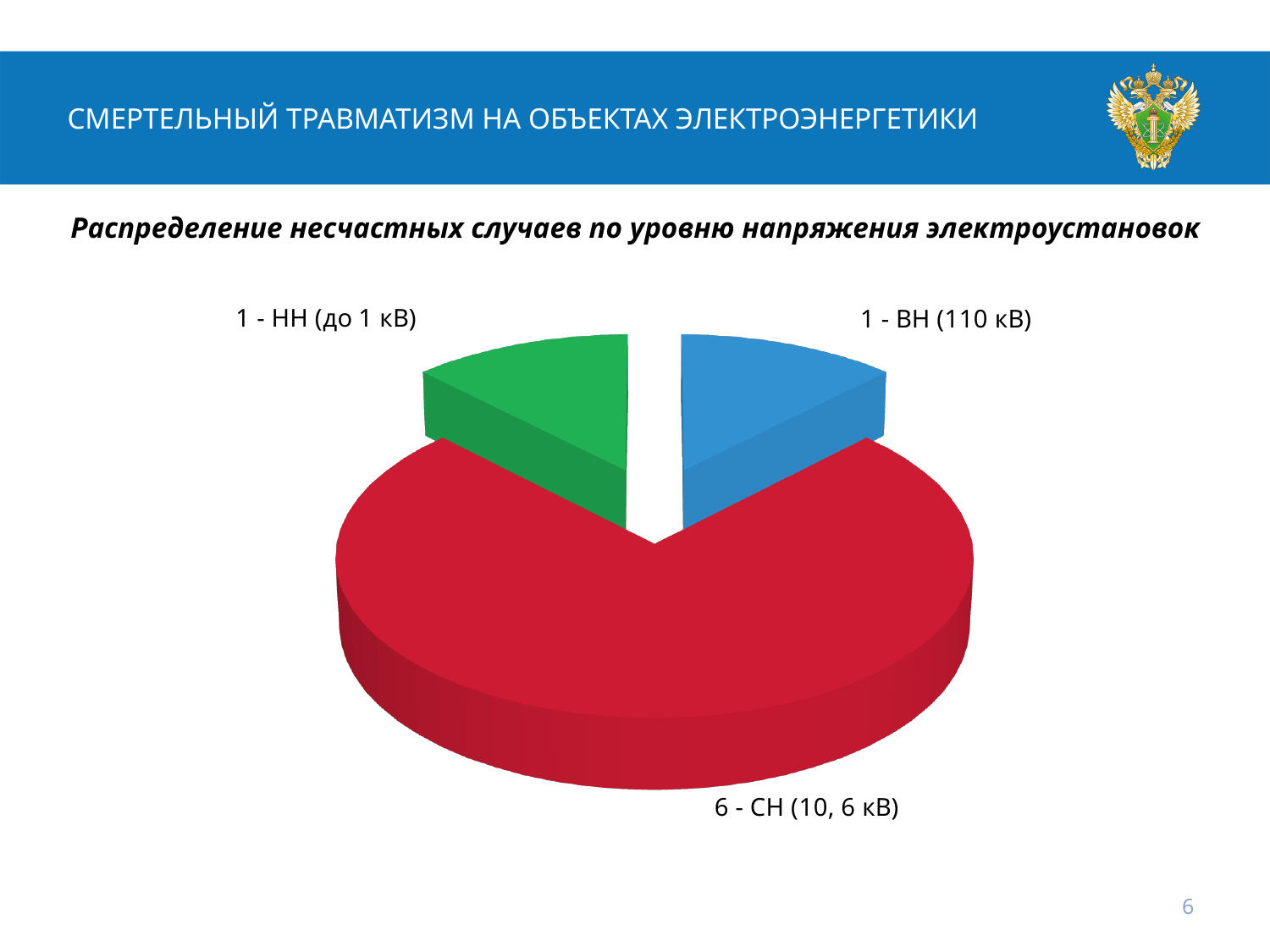
How many accidents are attributed to ВН (110 кВ) in the pie chart? 1 What share of the pie does the ВН (110 кВ) slice represent? 12.5% What is the total number of accidents across all slices of the pie chart? 8 How many slices does the pie chart have? 3 How many accidents are attributed to НН (до 1 кВ) in the pie chart? 1 What share of the pie does the СН (10, 6 кВ) slice represent? 75% What colour is the slice for СН (10, 6 кВ)? Red Which voltage level has the largest slice in the pie chart? СН (10, 6 кВ) What is the difference between the number of accidents for СН (10, 6 кВ) and for ВН (110 кВ)? 5 Which is larger: the value for СН (10, 6 кВ) or the value for НН (до 1 кВ)? СН (10, 6 кВ) What kind of chart is shown on the slide? Pie chart How many accidents are attributed to СН (10, 6 кВ) in the pie chart? 6